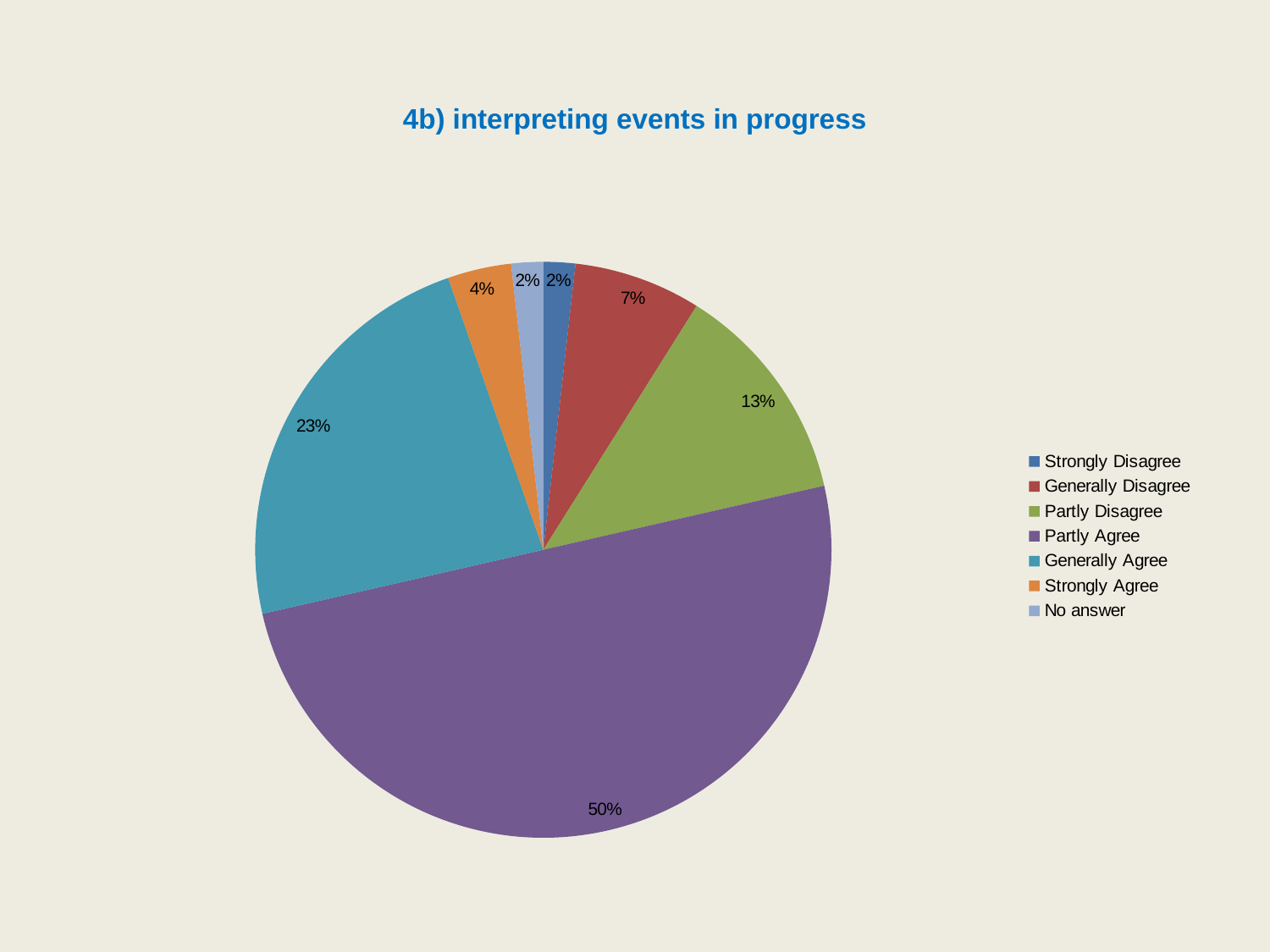
What percentage of responses are Generally Disagree? 7% What percentage of responses are Strongly Agree? 4% What percentage of responses are Generally Agree? 23% What kind of chart is shown on the slide? pie chart What is the difference in percentage points between Partly Agree and Generally Agree? 27 How many categories does the legend list? 7 What is the title of the chart? 4b) interpreting events in progress What percentage of responses are Partly Agree? 50% What is the combined share of Strongly Agree and No answer? 6% Which is larger, the share for Partly Disagree or the share for Generally Disagree? Partly Disagree Which category has the largest share of the pie? Partly Agree What percentage of responses are Partly Disagree? 13%